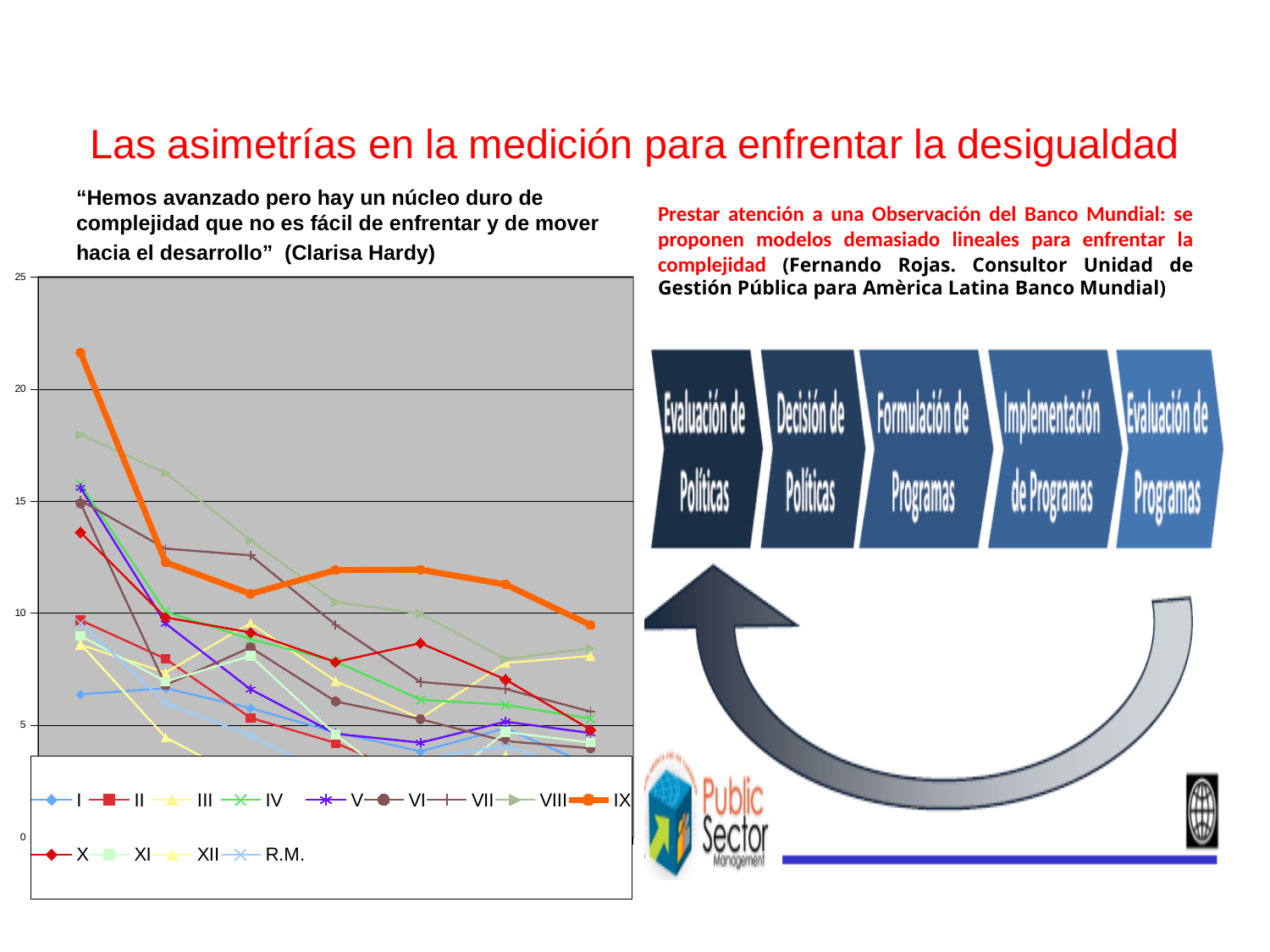
Does series IX in the line chart generally rise or fall from left to right? fall Is the value of series IX at the rightmost point greater or less than 10? less What kind of chart is shown on the left of the slide? line chart At the leftmost point of the line chart, which series has the larger value, I or X? X What is the highest value shown on the vertical axis of the line chart? 25 Which series in the line chart is drawn with the thick orange line? IX Is the value of series IX at the leftmost point greater or less than 20? greater Which series has the highest value at the leftmost point of the line chart? IX How many series does the legend of the line chart list? 13 Which series has the highest value at the rightmost point of the line chart? IX Is the value of series VIII at the leftmost point greater or less than 15? greater How many data points does series IX have in the line chart? 7